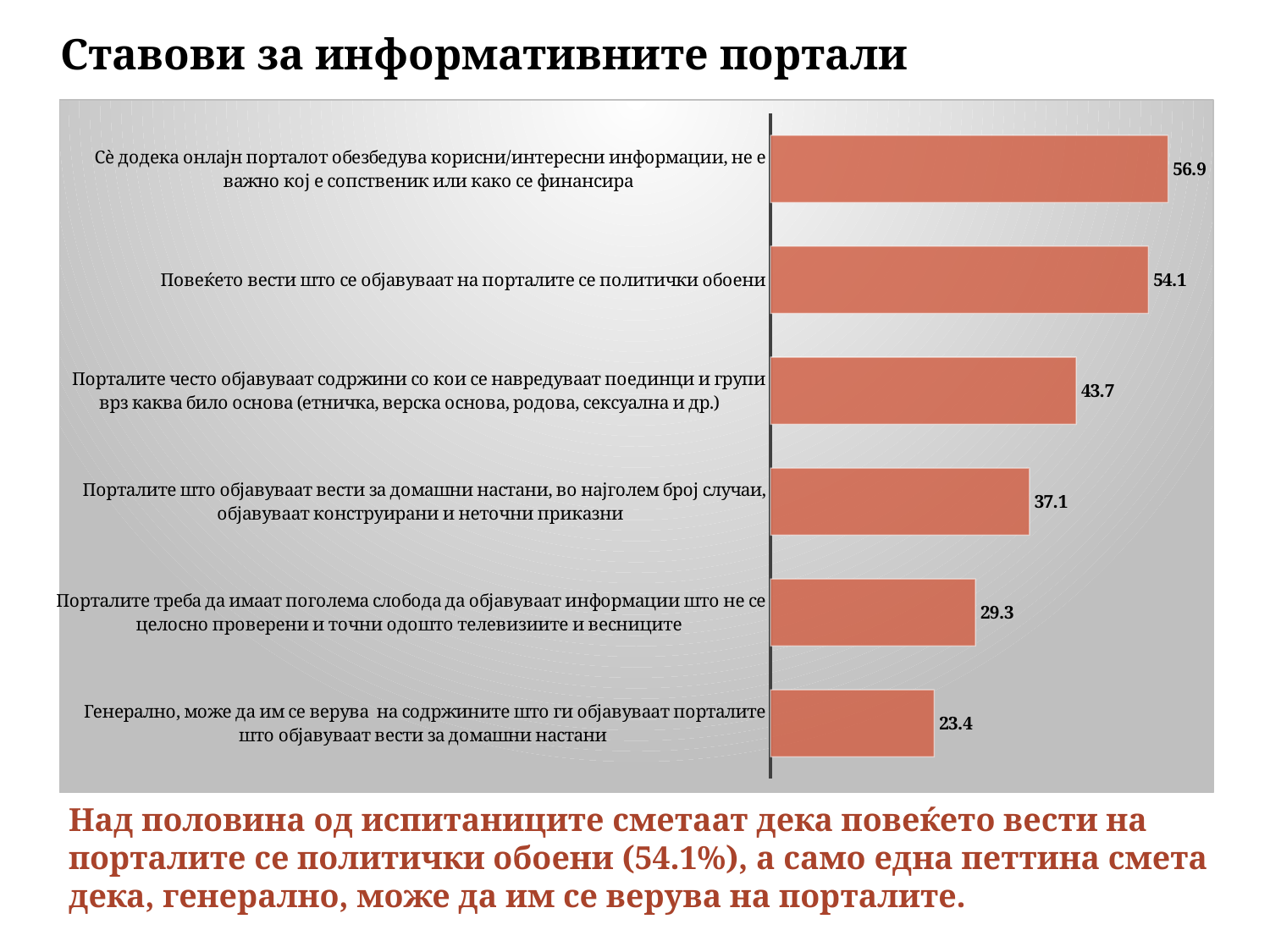
What is the difference between the value for the statement about insulting content (43.7) and the statement about constructed and inaccurate stories (37.1)? 6.6 What value is shown for the statement "Генерално, може да им се верува на содржините што ги објавуваат порталите што објавуваат вести за домашни настани"? 23.4 What is the title of the slide? Ставови за информативните портали What value is shown for the statement about portals often publishing content that insults individuals and groups ("Порталите често објавуваат содржини со кои се навредуваат поединци и групи...")? 43.7 What type of chart is shown on the slide? Bar chart Which has a larger value: the statement "Порталите треба да имаат поголема слобода..." or the statement "Генерално, може да им се верува..."? Порталите треба да имаат поголема слобода... How many statements (bars) are shown in the chart? 6 Which statement has the highest value in the chart? Сè додека онлајн порталот обезбедува корисни/интересни информации, не е важно кој е сопственик или како се финансира What is the difference between the highest value (56.9) and the value for "Повеќето вести што се објавуваат на порталите се политички обоени" (54.1)? 2.8 What value is shown for the statement "Порталите треба да имаат поголема слобода да објавуваат информации што не се целосно проверени и точни одошто телевизиите и весниците"? 29.3 Which statement has the lowest value in the chart? Генерално, може да им се верува на содржините што ги објавуваат порталите што објавуваат вести за домашни настани What value is shown for the statement "Повеќето вести што се објавуваат на порталите се политички обоени"? 54.1